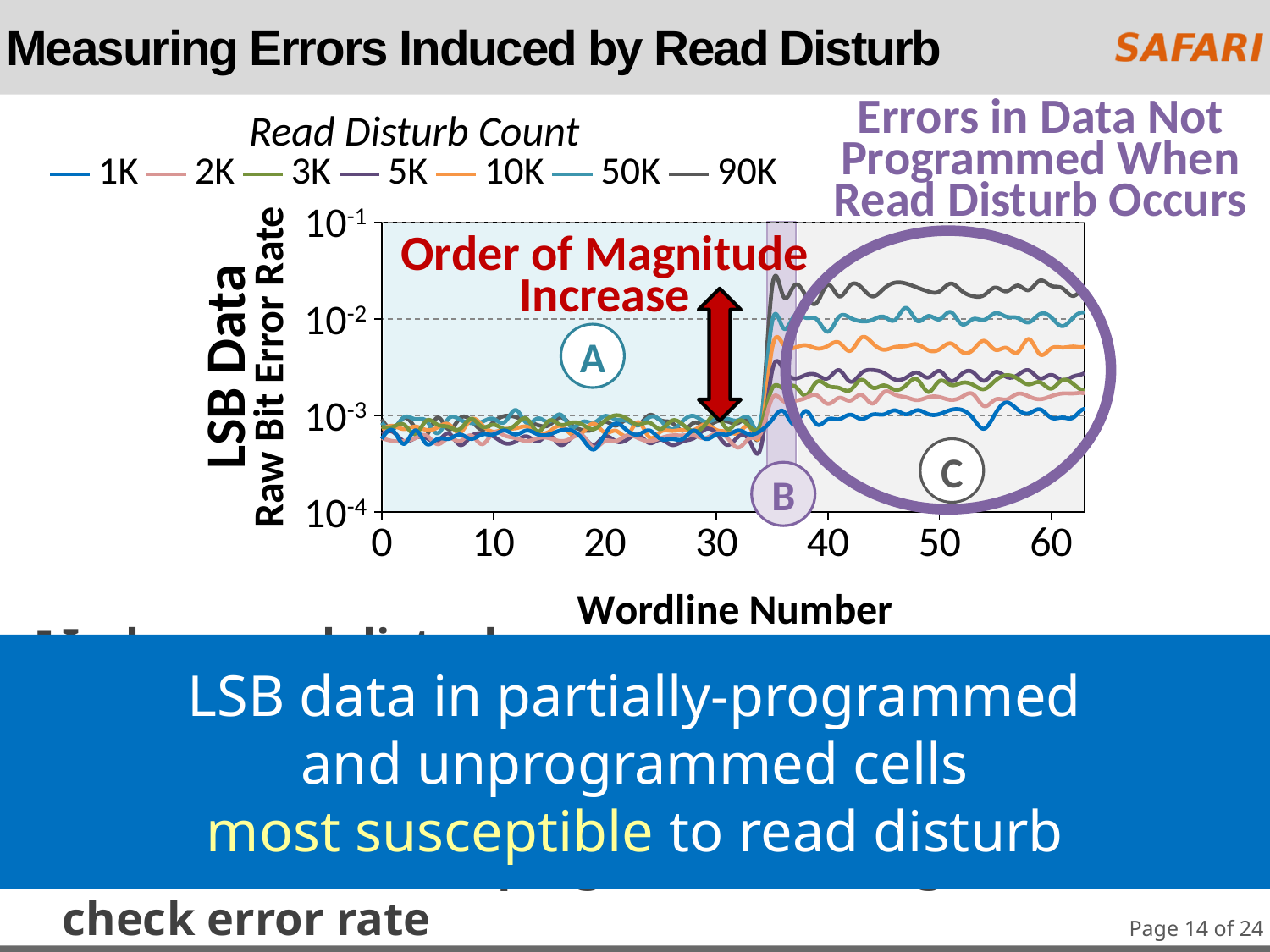
What kind of chart is shown on the slide? line chart What is the title of the legend above the chart? Read Disturb Count How many series does the legend list? 7 At wordline 20, is the raw bit error rate for the 90K series greater or less than 10^-2? less Which series has the highest raw bit error rate for wordlines above 40? 90K What is the label of the x axis? Wordline Number At wordline 50, is the raw bit error rate for the 90K series greater or less than 10^-2? greater At wordline 50, is the raw bit error rate for the 10K series greater or less than 10^-2? less Which series has the lowest raw bit error rate for wordlines above 40? 1K Does the raw bit error rate for the 90K series rise or fall when moving from wordline 30 to wordline 40? rise At wordline 50, which series has the larger raw bit error rate, 50K or 5K? 50K At wordline 50, which series has the larger raw bit error rate, 90K or 1K? 90K